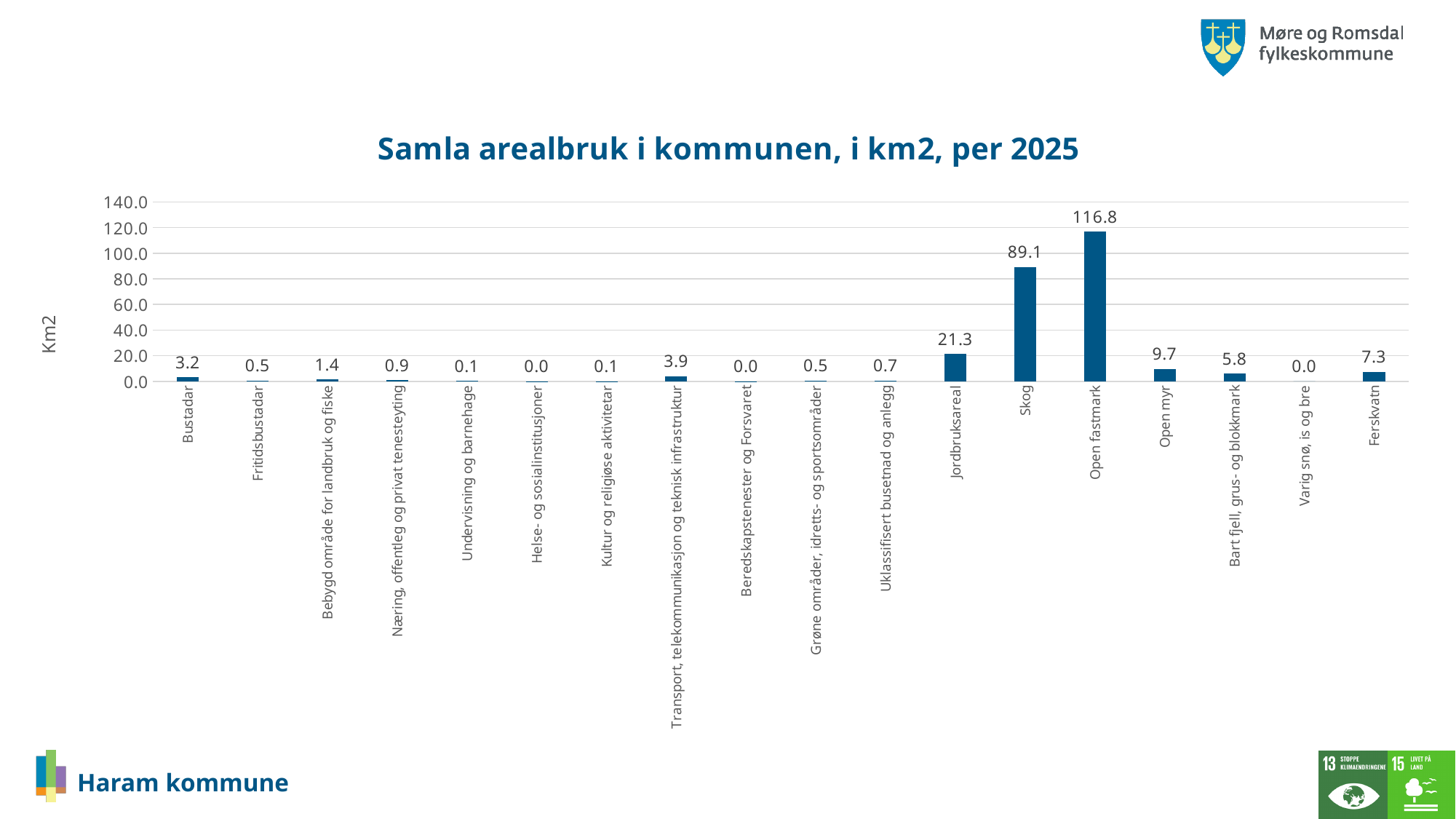
What is the value for Skog? 89.1 What is the title of the chart? Samla arealbruk i kommunen, i km2, per 2025 What is the value for Ferskvatn? 7.3 What kind of chart is shown? bar chart How many categories are shown on the x axis? 18 What is the value for Jordbruksareal? 21.3 Is the value for Skog greater or less than 100.0? less What is the value for Bustadar? 3.2 Which category has the highest value? Open fastmark Which is larger, Jordbruksareal or Open myr? Jordbruksareal What is the difference between Open fastmark and Skog? 27.7 What is the difference between Open myr and Bart fjell, grus- og blokkmark? 3.9